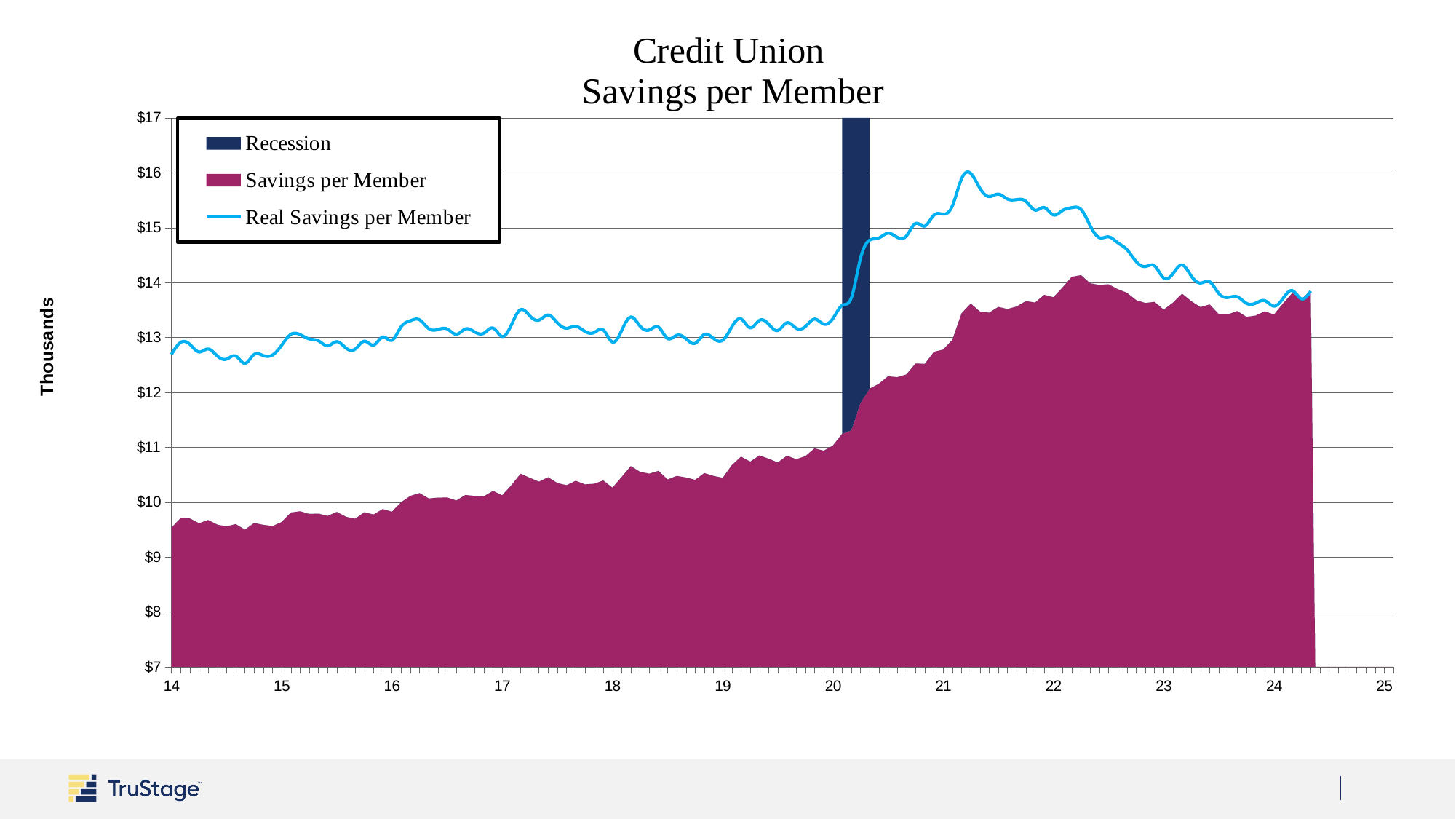
At 14, which is higher: Savings per Member or Real Savings per Member? Real Savings per Member Is the value of Real Savings per Member at 22 greater or less than $15? greater What is the label on the vertical axis? Thousands Is the value of Savings per Member at 14 greater or less than $10? less Does Savings per Member generally rise or fall from 14 to 24? rise What is the title of the chart? Credit Union Savings per Member Is the value of Savings per Member at 18 greater or less than $10? greater How many entries does the legend list? 3 Does Real Savings per Member rise or fall from 21 to 24? fall What kind of chart is shown on the slide? Area chart with a line